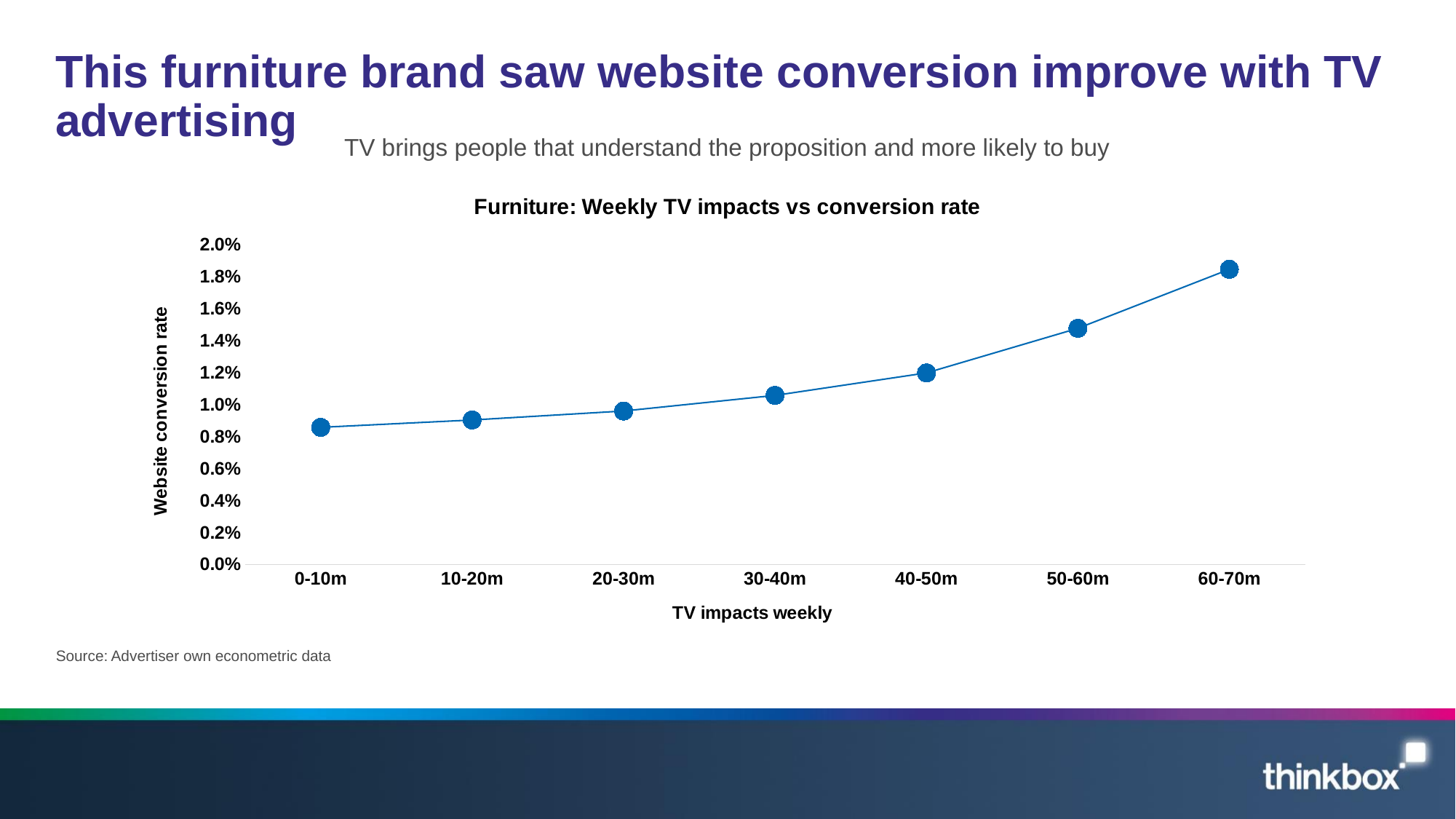
Is the website conversion rate for 50-60m greater or less than 1.2%? greater Is the website conversion rate for 60-70m greater or less than 1.6%? greater Is the website conversion rate for 30-40m greater or less than 1.2%? less Which TV impacts category has the lowest website conversion rate? 0-10m Which has the higher website conversion rate, 50-60m or 40-50m? 50-60m What kind of chart is shown on the slide? Line chart What is the title of the chart? Furniture: Weekly TV impacts vs conversion rate How many TV impact categories are plotted on the x axis? 7 Does the website conversion rate rise or fall as weekly TV impacts increase along the x axis? Rise What is the label of the y axis? Website conversion rate Which TV impacts category has the highest website conversion rate? 60-70m